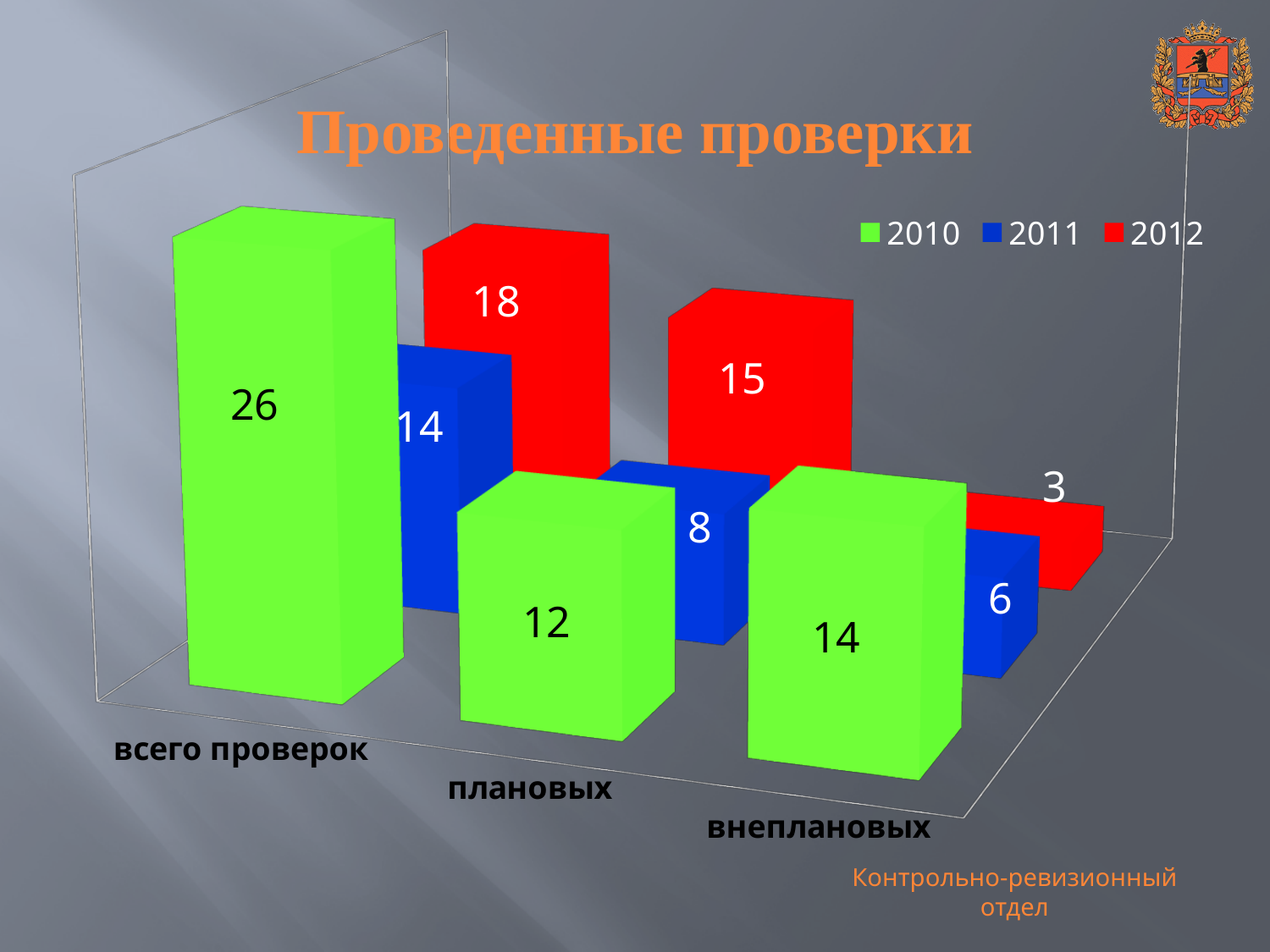
What is the value for 2010 in the "всего проверок" category? 26 What kind of chart is shown on the slide? bar chart How many categories are shown on the x axis? 3 Which year has the lowest value in the "внеплановых" category? 2012 Which is larger in the "плановых" category: the value for 2010 or the value for 2012? 2012 What is the title of the chart? Проведенные проверки What is the value for 2012 in the "плановых" category? 15 What is the value for 2011 in the "внеплановых" category? 6 Which year has the highest value in the "всего проверок" category? 2010 What is the value for 2012 in the "внеплановых" category? 3 How many series does the legend list? 3 What is the difference between the 2010 and 2011 values in the "всего проверок" category? 12